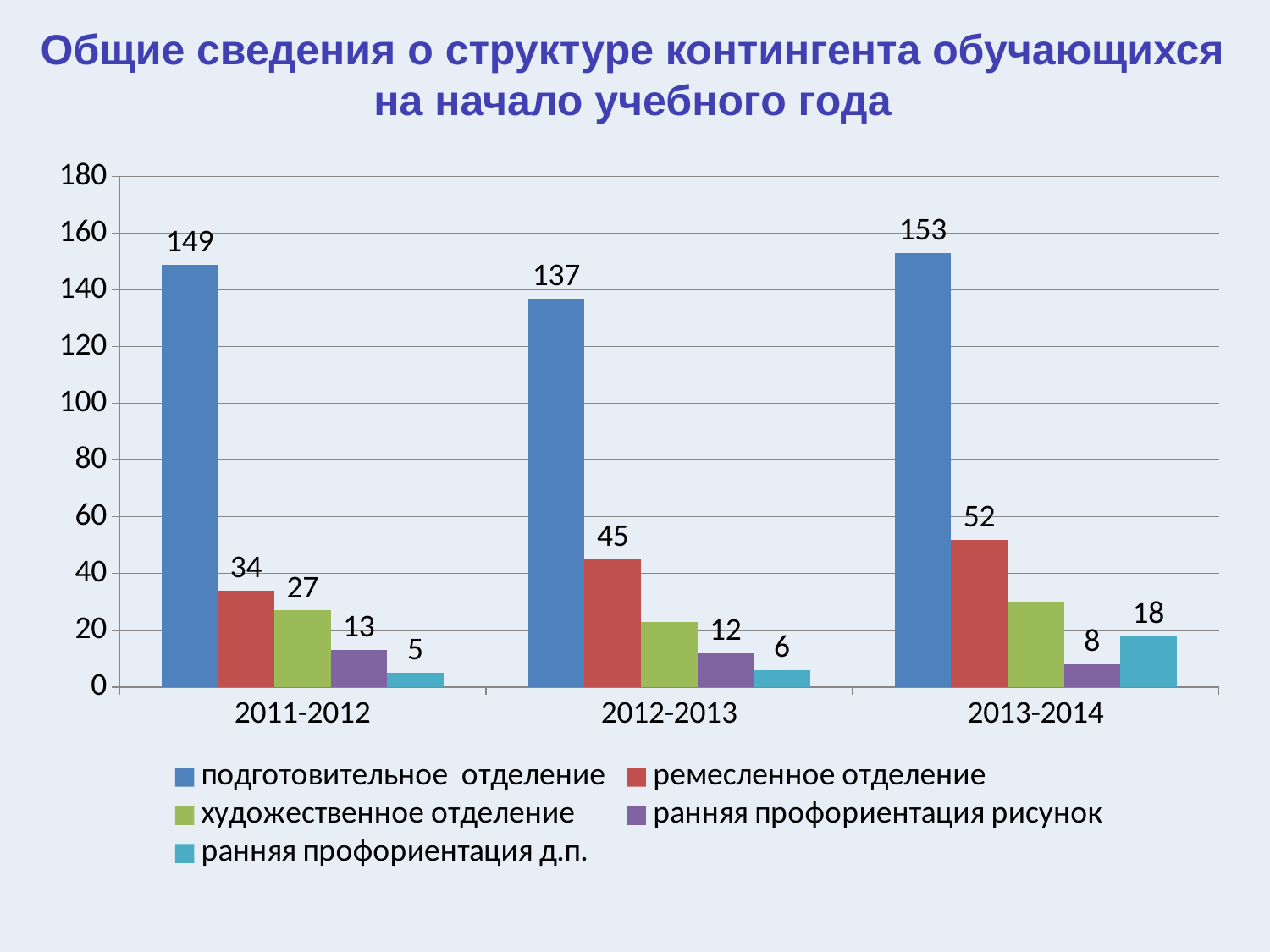
How many series does the legend list? 5 In which year is the value for ранняя профориентация д.п. the lowest? 2011-2012 What is the value for ремесленное отделение in 2013-2014? 52 How many year categories are shown on the x axis? 3 What kind of chart is shown on the slide? bar chart What is the value for ранняя профориентация рисунок in 2012-2013? 12 What is the value for подготовительное отделение in 2011-2012? 149 Which is larger: ремесленное отделение in 2011-2012 or ремесленное отделение in 2012-2013? 2012-2013 In which year is the value for подготовительное отделение the highest? 2013-2014 What is the value for ранняя профориентация д.п. in 2013-2014? 18 What is the difference between the подготовительное отделение values for 2013-2014 and 2012-2013? 16